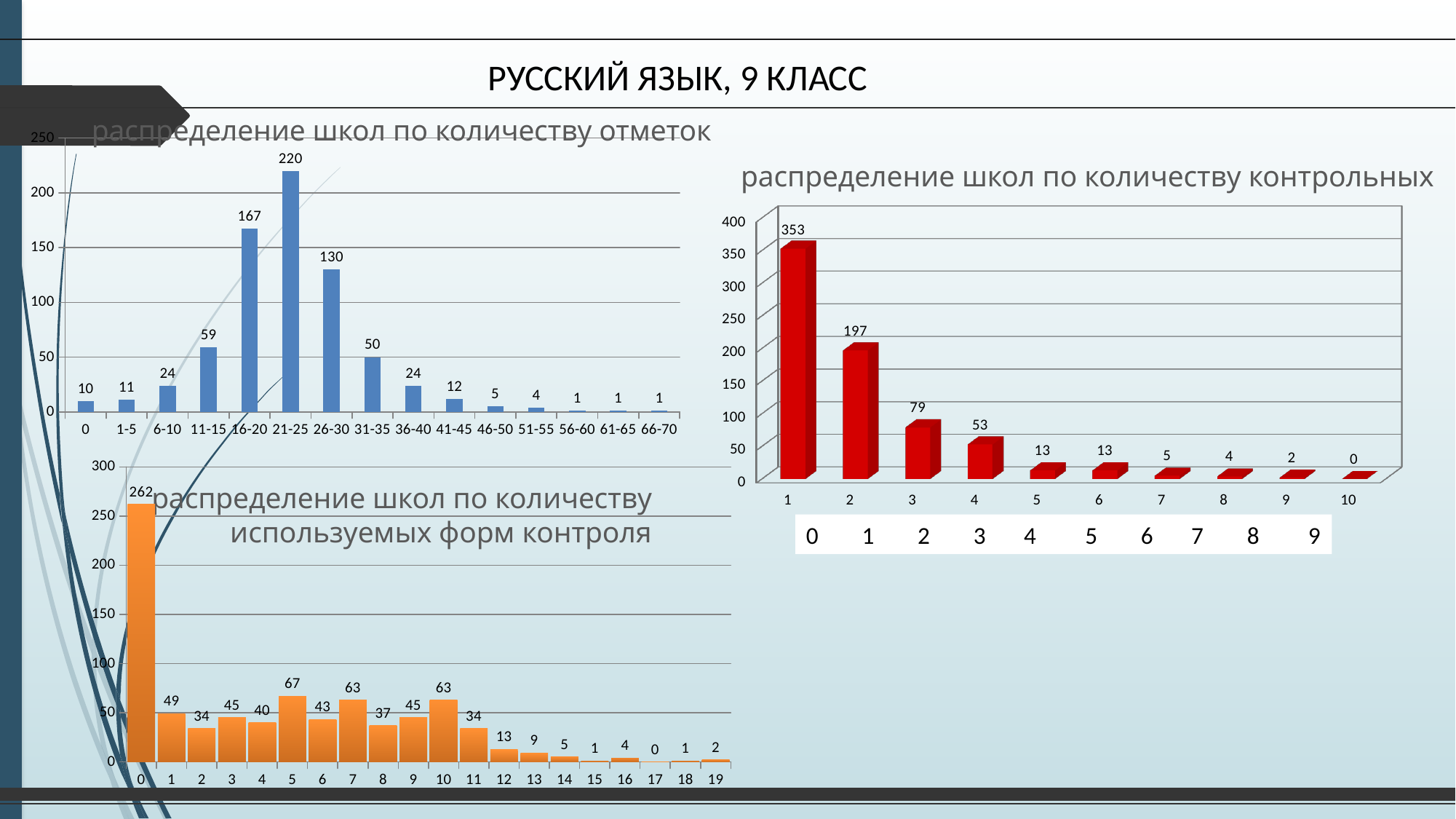
In the chart 'распределение школ по количеству контрольных', do the values rise or fall from left to right? fall In the chart 'распределение школ по количеству отметок', which category has the highest value? 21-25 In the chart 'распределение школ по количеству отметок', what is the difference between the values for 16-20 and 26-30? 37 What colour are the bars in the chart 'распределение школ по количеству используемых форм контроля'? orange In the chart 'распределение школ по количеству используемых форм контроля', which is larger, the value for 5 or the value for 6? 5 In the chart 'распределение школ по количеству используемых форм контроля', what is the value for category 0? 262 How many categories are shown on the x axis of the chart 'распределение школ по количеству отметок'? 15 In the chart 'распределение школ по количеству контрольных', what is the value of the tallest bar? 353 What kind of chart is 'распределение школ по количеству контрольных'? bar chart In the chart 'распределение школ по количеству используемых форм контроля', what is the difference between the values for 1 and 2? 15 In the chart 'распределение школ по количеству контрольных', what is the value of the third bar from the left? 79 In the chart 'распределение школ по количеству отметок', what is the value for the category 21-25? 220